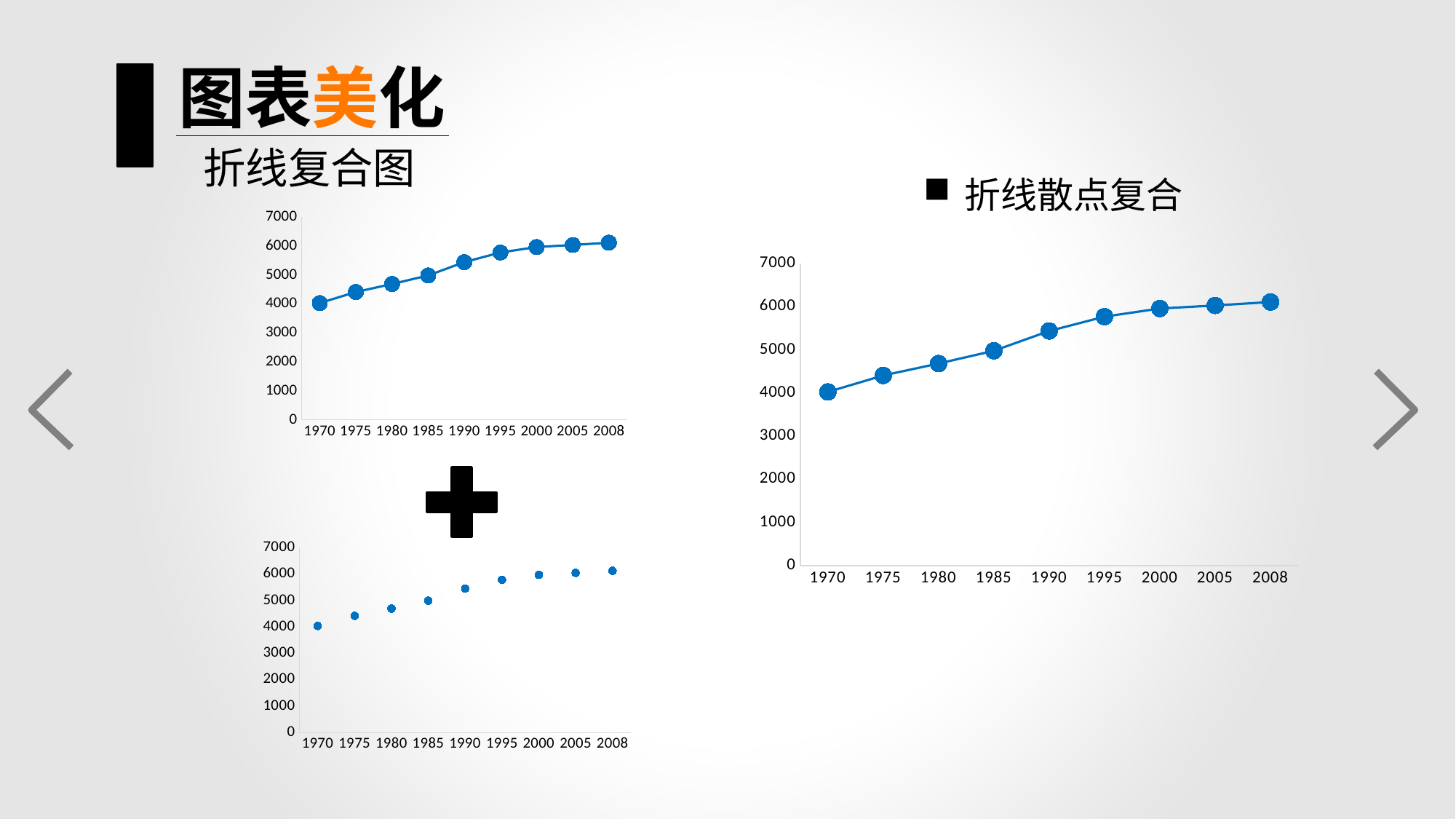
What is the highest tick value on the y axis of the large chart on the right? 7000 On the top-left chart, is the value for 1975 greater or less than 5000? less What kind of chart is the bottom-left chart on the slide? scatter chart On the large chart on the right, how many data points are plotted? 9 On the large chart on the right, do the values rise or fall from 1970 to 2008? rise What kind of chart is the large chart on the right of the slide? line chart On the large chart on the right, is the value for 1970 greater or less than 5000? less What is the first year shown on the x axis of the bottom-left chart? 1970 On the large chart on the right, which is larger, the value for 1990 or the value for 1980? 1990 On the large chart on the right, is the value for 2008 greater or less than 5000? greater On the large chart on the right, which year has the lowest value? 1970 On the large chart on the right, which year has the highest value? 2008